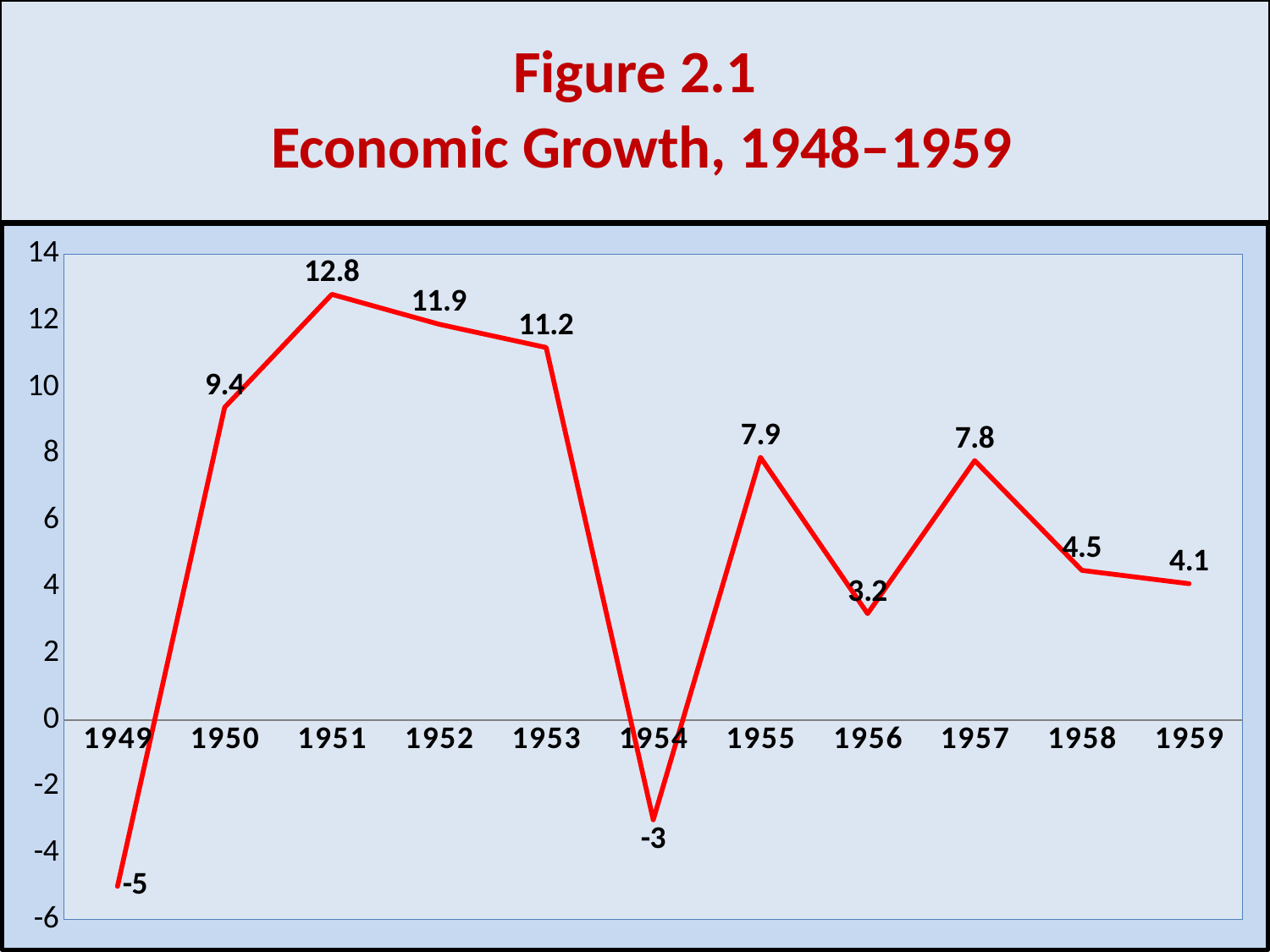
Which year has a larger value, 1950 or 1955? 1950 What kind of chart is shown on the slide? Line chart How many years are plotted on the chart? 11 What is the difference between the values for 1958 and 1959? 0.4 What is the economic growth value for 1959? 4.1 What is the difference between the values for 1951 and 1952? 0.9 Do the values rise or fall from 1951 to 1953? Fall What is the economic growth value for 1949? -5 What is the economic growth value for 1954? -3 Which year has the highest economic growth value? 1951 Which year has the lowest economic growth value? 1949 What is the economic growth value for 1951? 12.8